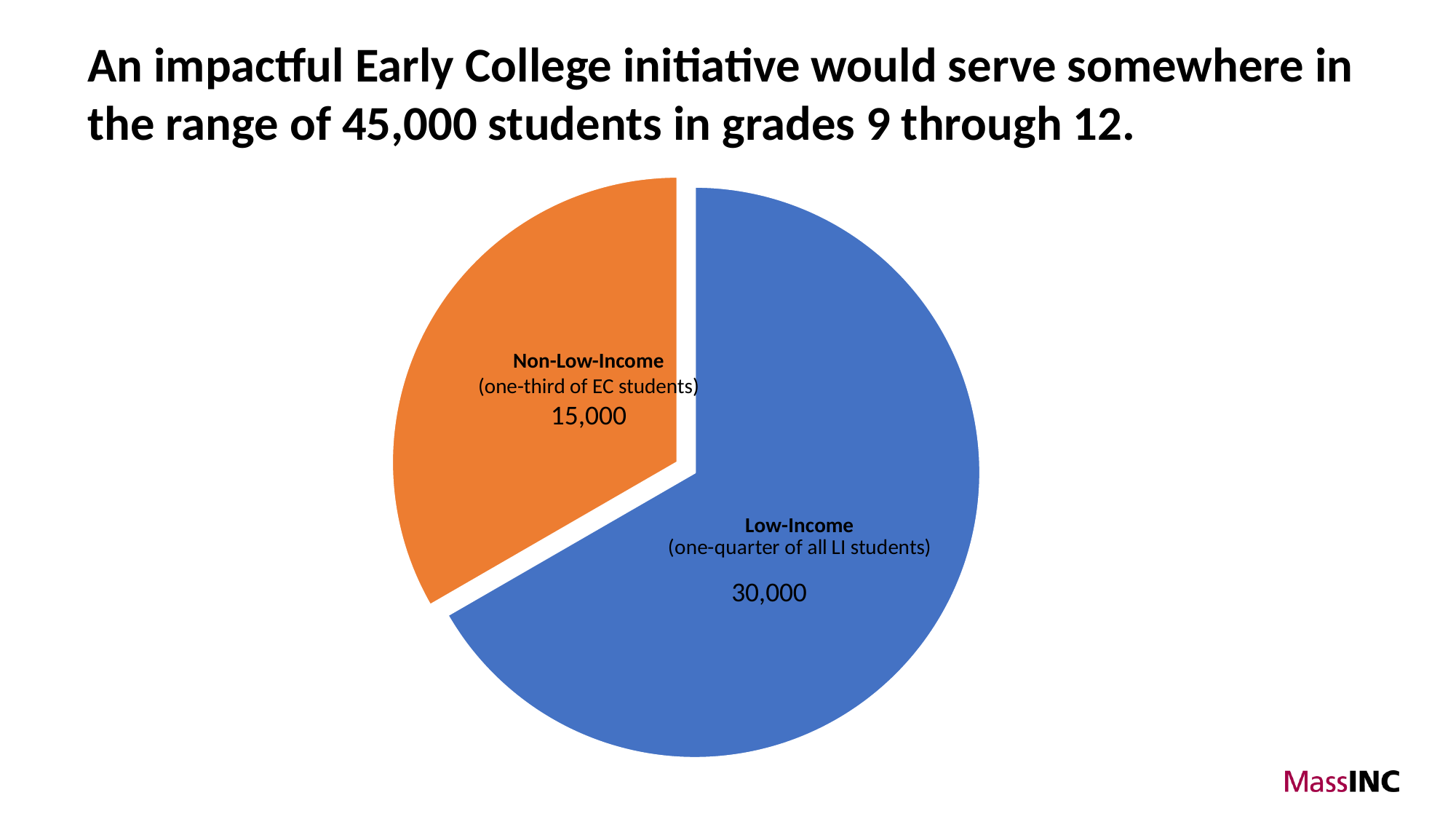
What kind of chart is shown on the slide? Pie chart What share of the pie does the Non-Low-Income slice represent? One-third How many slices does the pie chart have? 2 Which slice is the largest? Low-Income What is the value for the Low-Income slice? 30,000 What is the difference between the Low-Income and Non-Low-Income values? 15,000 What is the total of the two slices in the pie chart? 45,000 Which slice is the smallest? Non-Low-Income What colour is the Low-Income slice? Blue Which is larger, the Low-Income slice or the Non-Low-Income slice? Low-Income What colour is the Non-Low-Income slice? Orange What is the value for the Non-Low-Income slice? 15,000